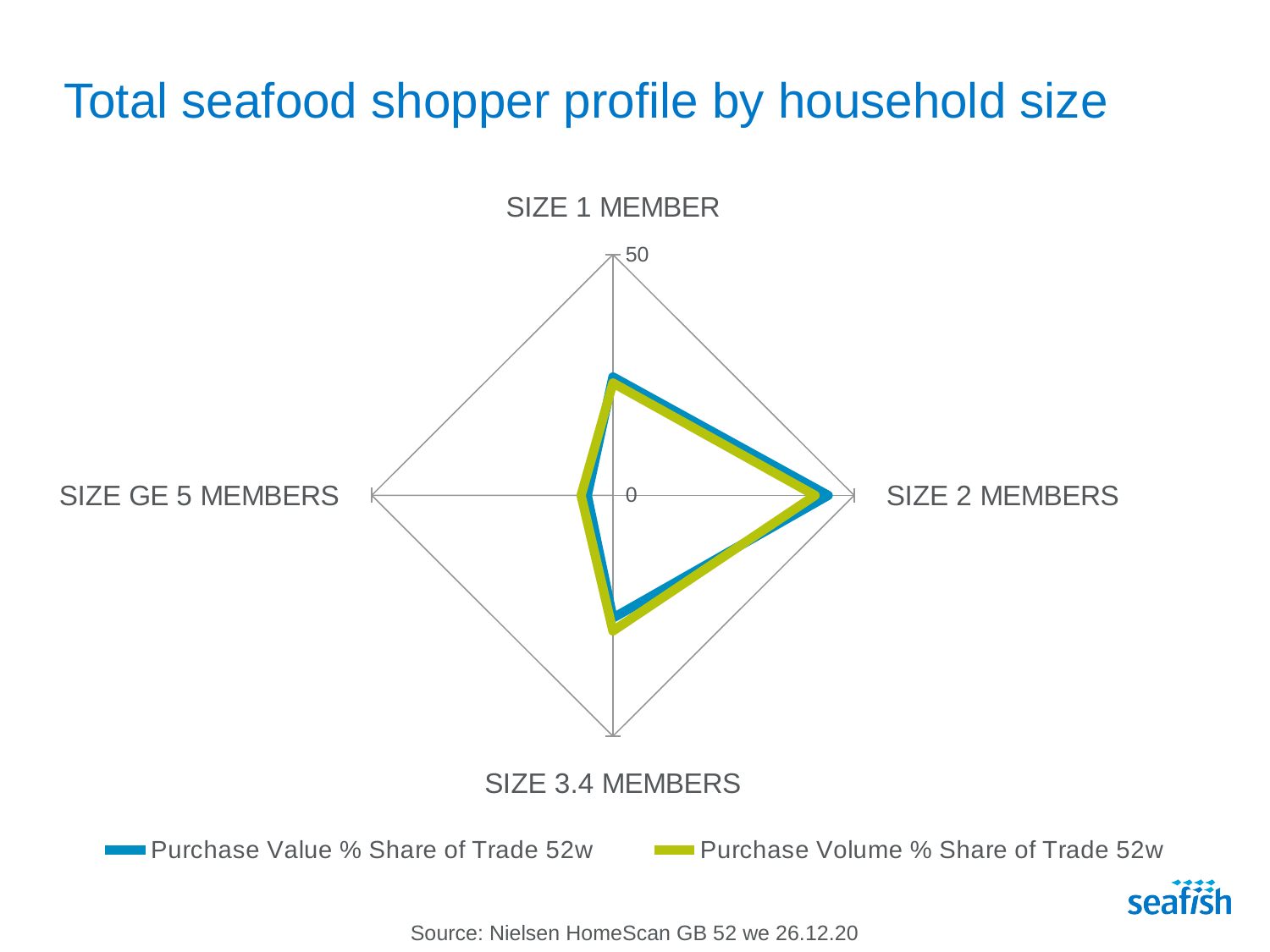
What kind of chart is shown on the slide? Radar chart Which household size category has the lowest Purchase Volume % Share of Trade 52w? SIZE GE 5 MEMBERS How many household size categories are plotted on the radar chart? 4 What is the title of the chart on the slide? Total seafood shopper profile by household size Which series is shown in green in the legend? Purchase Volume % Share of Trade 52w Which is larger for Purchase Value % Share of Trade 52w: SIZE 2 MEMBERS or SIZE 1 MEMBER? SIZE 2 MEMBERS Is the Purchase Volume % Share of Trade 52w for SIZE GE 5 MEMBERS greater or less than 50? less How many series does the legend list? 2 Which household size category has the highest Purchase Value % Share of Trade 52w? SIZE 2 MEMBERS Is the Purchase Value % Share of Trade 52w for SIZE 2 MEMBERS greater or less than 50? less Which is larger for Purchase Volume % Share of Trade 52w: SIZE 1 MEMBER or SIZE GE 5 MEMBERS? SIZE 1 MEMBER